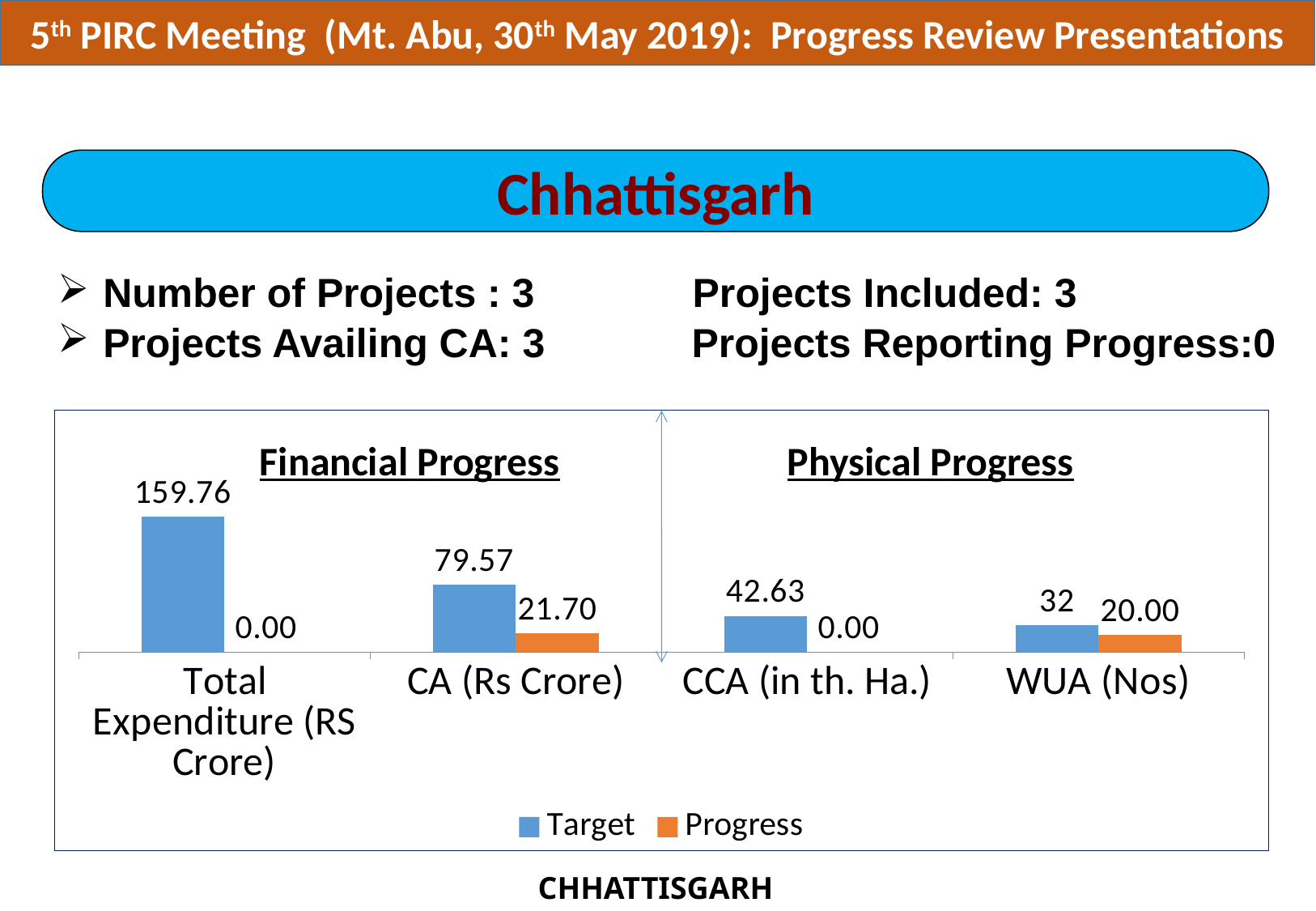
Which category has the highest Target value? Total Expenditure (RS Crore) How many categories are shown on the x axis of the chart? 4 What is the Progress value for CA (Rs Crore)? 21.70 What is the Target value for Total Expenditure (RS Crore)? 159.76 What is the Progress value for WUA (Nos)? 20.00 Which category has the lowest Target value? WUA (Nos) What is the Target value for CCA (in th. Ha.)? 42.63 Which is larger, the Target for CA (Rs Crore) or the Target for CCA (in th. Ha.)? CA (Rs Crore) What kind of chart is shown on the slide? Bar chart How many series does the legend list? 2 What is the difference between the Target and Progress values for CA (Rs Crore)? 57.87 Which colour represents the Progress series in the chart? Orange